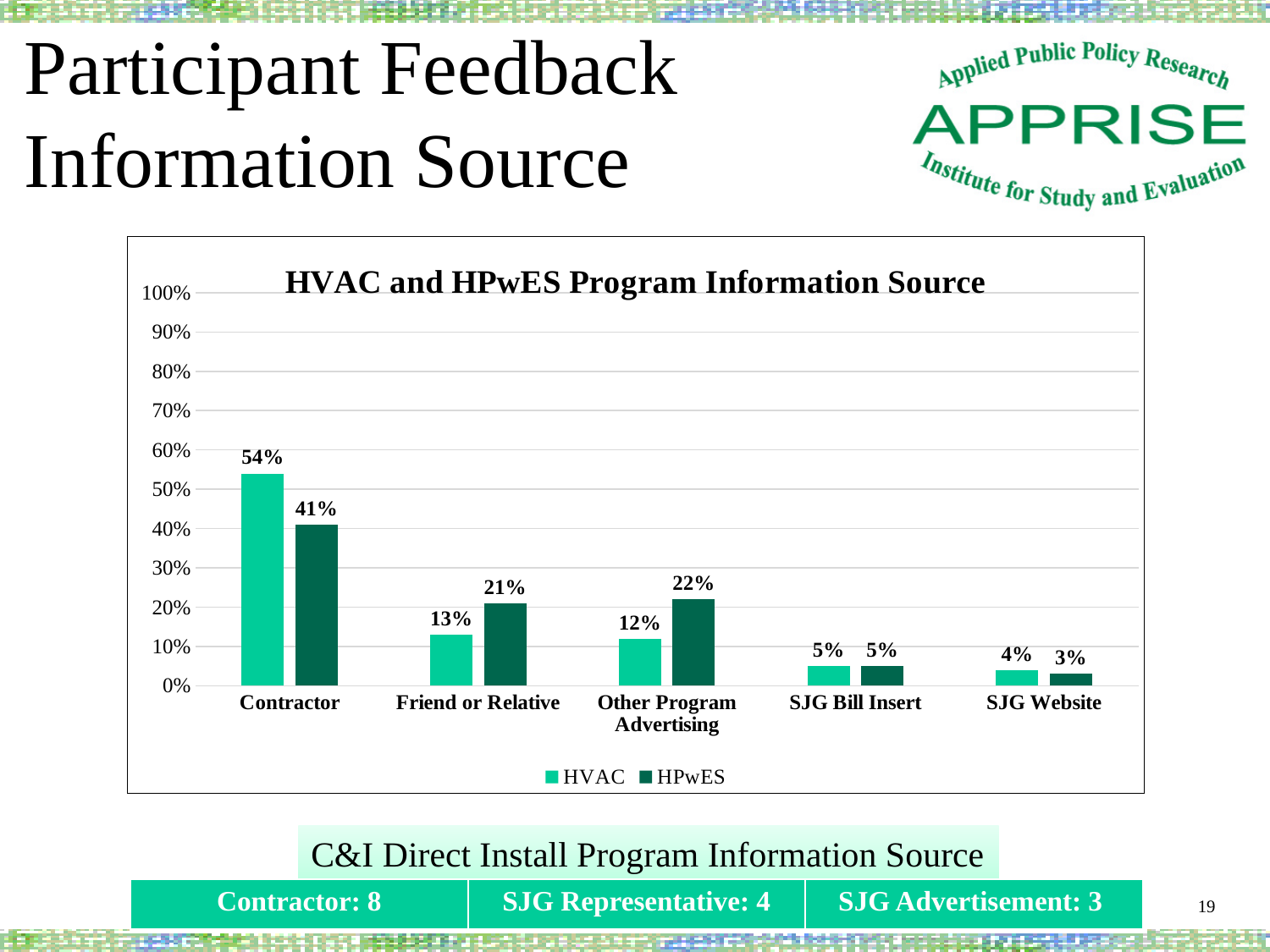
What is the HPwES value for Friend or Relative? 21% Which category has the lowest HPwES value? SJG Website What is the title of the chart? HVAC and HPwES Program Information Source What is the difference between the HVAC and HPwES values for Contractor? 13% What is the HVAC value for Contractor? 54% What kind of chart is shown? Bar chart Which category has the highest HVAC value? Contractor How many categories are shown on the x axis? 5 What is the HPwES value for SJG Website? 3% Which is larger for Other Program Advertising, the HVAC value or the HPwES value? HPwES What is the HVAC value for Other Program Advertising? 12% How many series does the legend list? 2